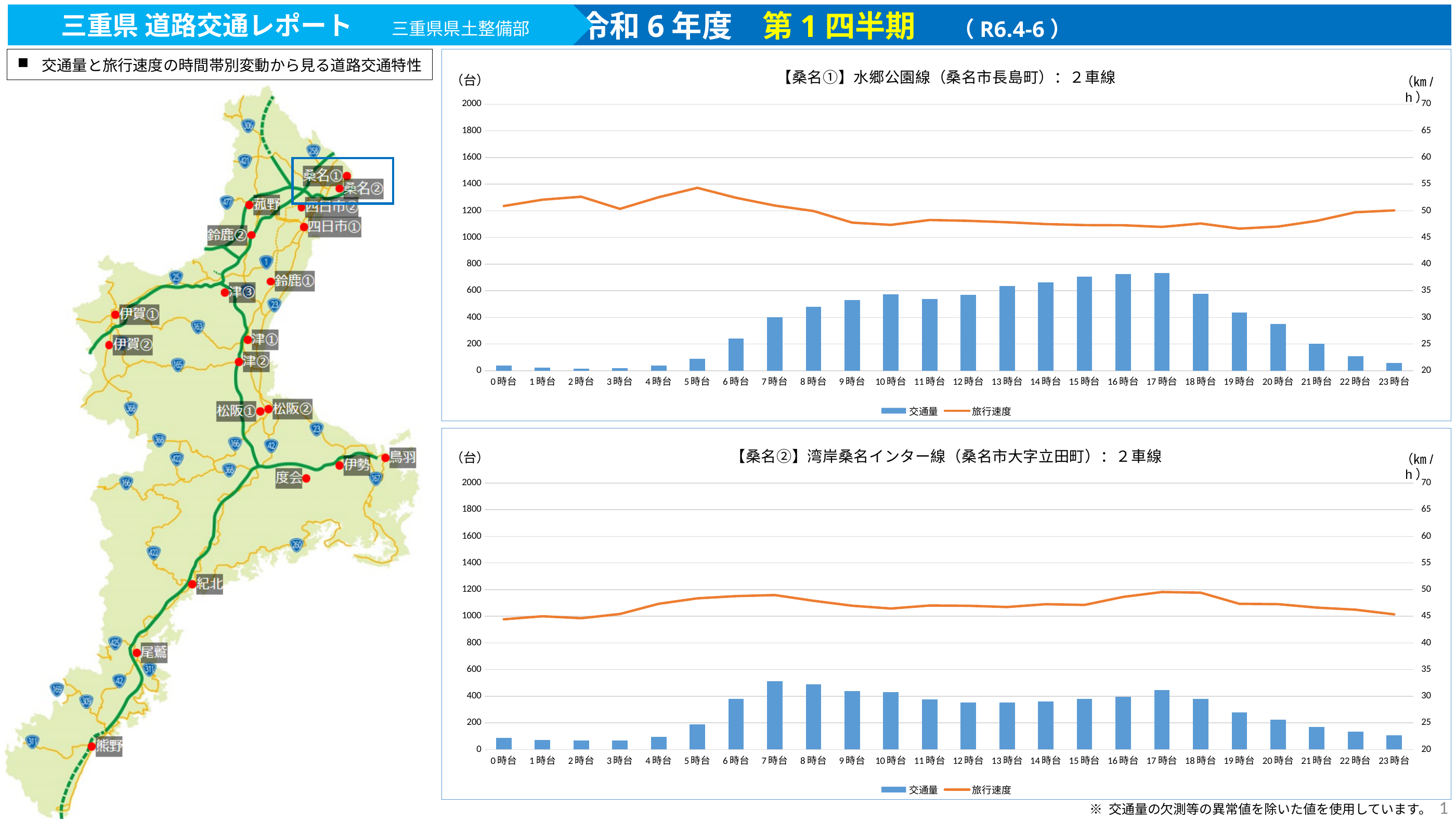
On the bottom chart (【桑名②】湾岸桑名インター線), which has the larger traffic volume (交通量), 7時台 or 13時台? 7時台 On the bottom chart (【桑名②】湾岸桑名インター線), is the traffic volume (交通量) bar for 7時台 greater or less than 400? greater How many series does the legend of the bottom chart (【桑名②】湾岸桑名インター線) list? 2 On the bottom chart (【桑名②】湾岸桑名インター線), does the traffic volume (交通量) rise or fall from 17時台 to 23時台? fall On the top chart (【桑名①】水郷公園線), which has the larger traffic volume (交通量), 17時台 or 5時台? 17時台 On the top chart (【桑名①】水郷公園線), is the traffic volume (交通量) bar for 17時台 greater or less than 600? greater What are the two legend entries on the top chart (【桑名①】水郷公園線)? 交通量 and 旅行速度 On the top chart (【桑名①】水郷公園線), is the traffic volume (交通量) bar for 5時台 greater or less than 200? less On the top chart (【桑名①】水郷公園線), does the traffic volume (交通量) rise or fall from 0時台 to 17時台? rise How many time-of-day categories are shown on the x axis of the top chart (【桑名①】水郷公園線)? 24